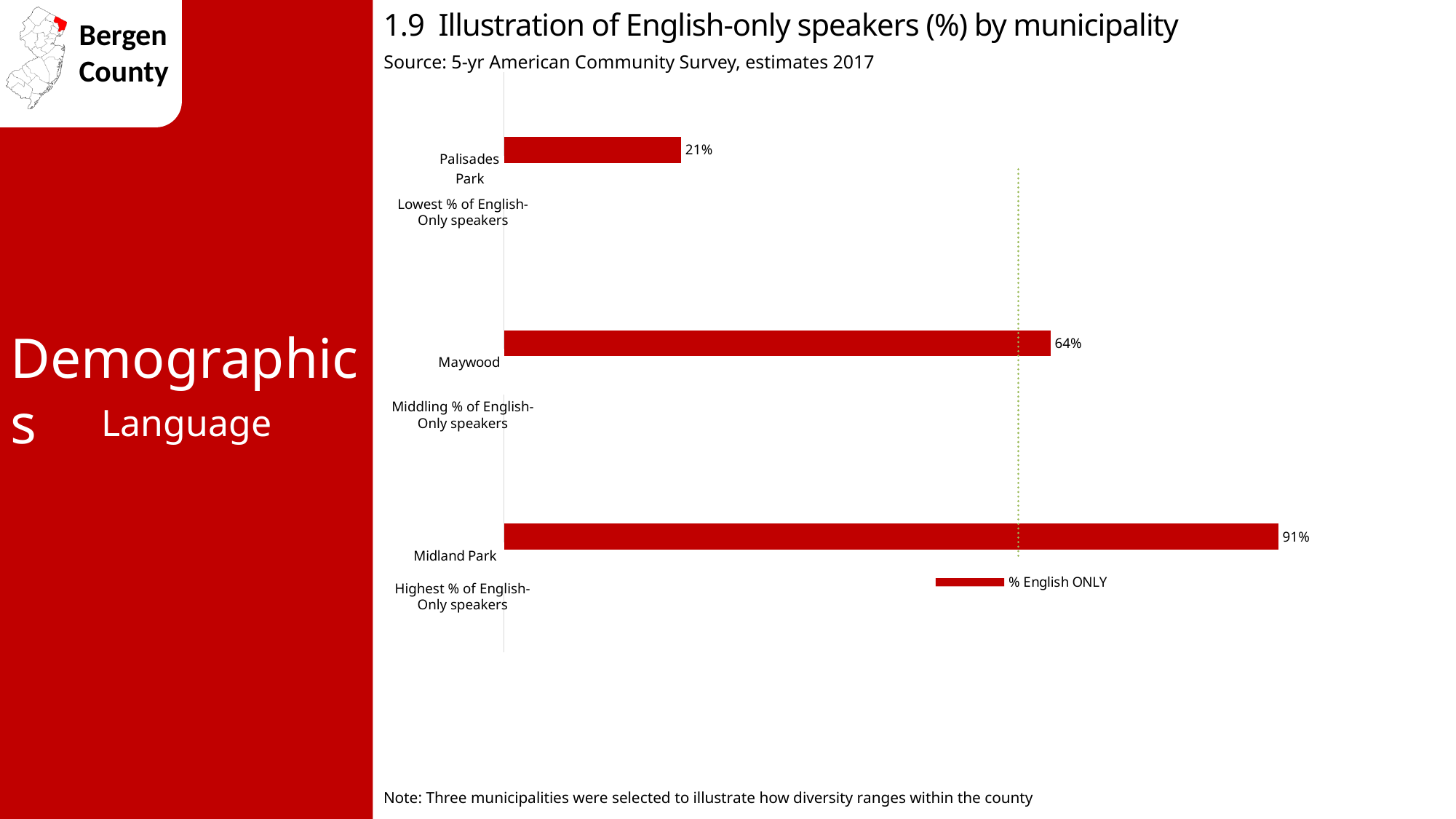
What is the difference in percentage points between Maywood and Palisades Park? 43 What kind of chart is used on this slide? Bar chart What percentage of English-only speakers is shown for Palisades Park? 21% What percentage of English-only speakers is shown for Maywood? 64% What is the difference in percentage points between Midland Park and Palisades Park? 70 Which municipality has the highest percentage of English-only speakers? Midland Park How many series does the legend list? 1 Which has a higher percentage of English-only speakers, Maywood or Palisades Park? Maywood What percentage of English-only speakers is shown for Midland Park? 91% What is the legend entry for the series shown in the chart? % English ONLY Which municipality has the lowest percentage of English-only speakers? Palisades Park How many municipalities are shown in the chart? 3